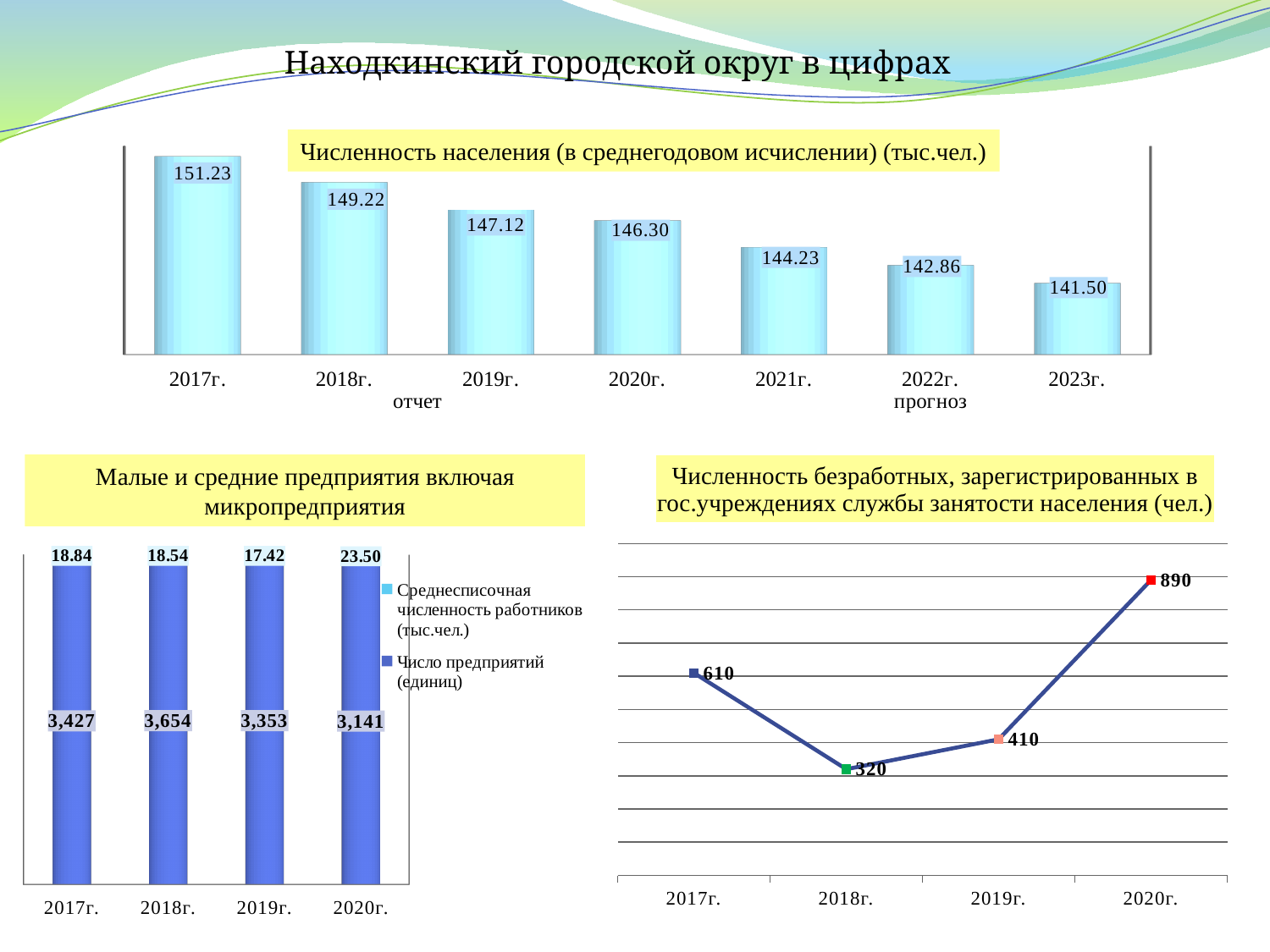
What kind of chart is the unemployed chart (Численность безработных)? line chart In the small and medium enterprises chart (Малые и средние предприятия), what is the average number of employees (Среднесписочная численность работников) for 2020г.? 23.50 How many series does the legend of the small and medium enterprises chart (Малые и средние предприятия) list? 2 How many years are shown in the population chart (Численность населения)? 7 In the population chart (Численность населения), do the values rise or fall from 2017г. to 2023г.? fall In the unemployed chart (Численность безработных), what is the value for 2018г.? 320 In the population chart (Численность населения), what is the difference between the 2017г. and 2023г. values? 9.73 In the population chart (Численность населения), what is the value for 2019г.? 147.12 In the unemployed chart (Численность безработных), what is the difference between the 2020г. and 2019г. values? 480 In the population chart (Численность населения), which year has the lowest value? 2023г. In the small and medium enterprises chart (Малые и средние предприятия), which year has the highest number of enterprises (Число предприятий)? 2018г. In the small and medium enterprises chart (Малые и средние предприятия), what is the number of enterprises (Число предприятий) for 2018г.? 3,654